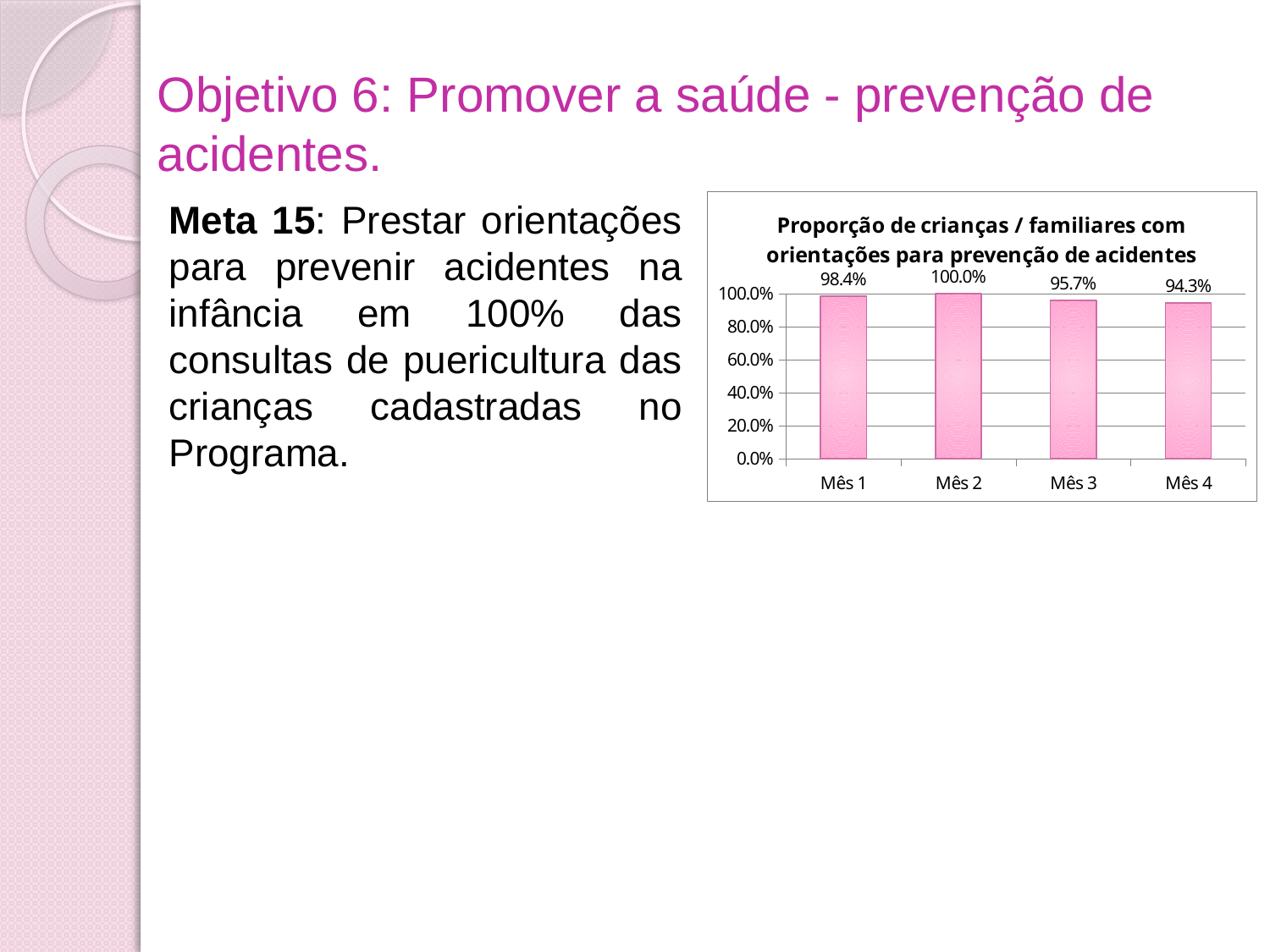
What is the value for Mês 4? 94.3% What is the value for Mês 2? 100.0% What is the value for Mês 3? 95.7% Which is larger, the value for Mês 1 or the value for Mês 3? Mês 1 What is the difference between the values for Mês 2 and Mês 4? 5.7% Which month has the highest value? Mês 2 How many months are shown on the x axis? 4 Do the values rise or fall from Mês 2 to Mês 4? Fall Which month has the lowest value? Mês 4 What kind of chart is shown on the slide? Bar chart What is the title of the chart? Proporção de crianças / familiares com orientações para prevenção de acidentes What is the value for Mês 1? 98.4%